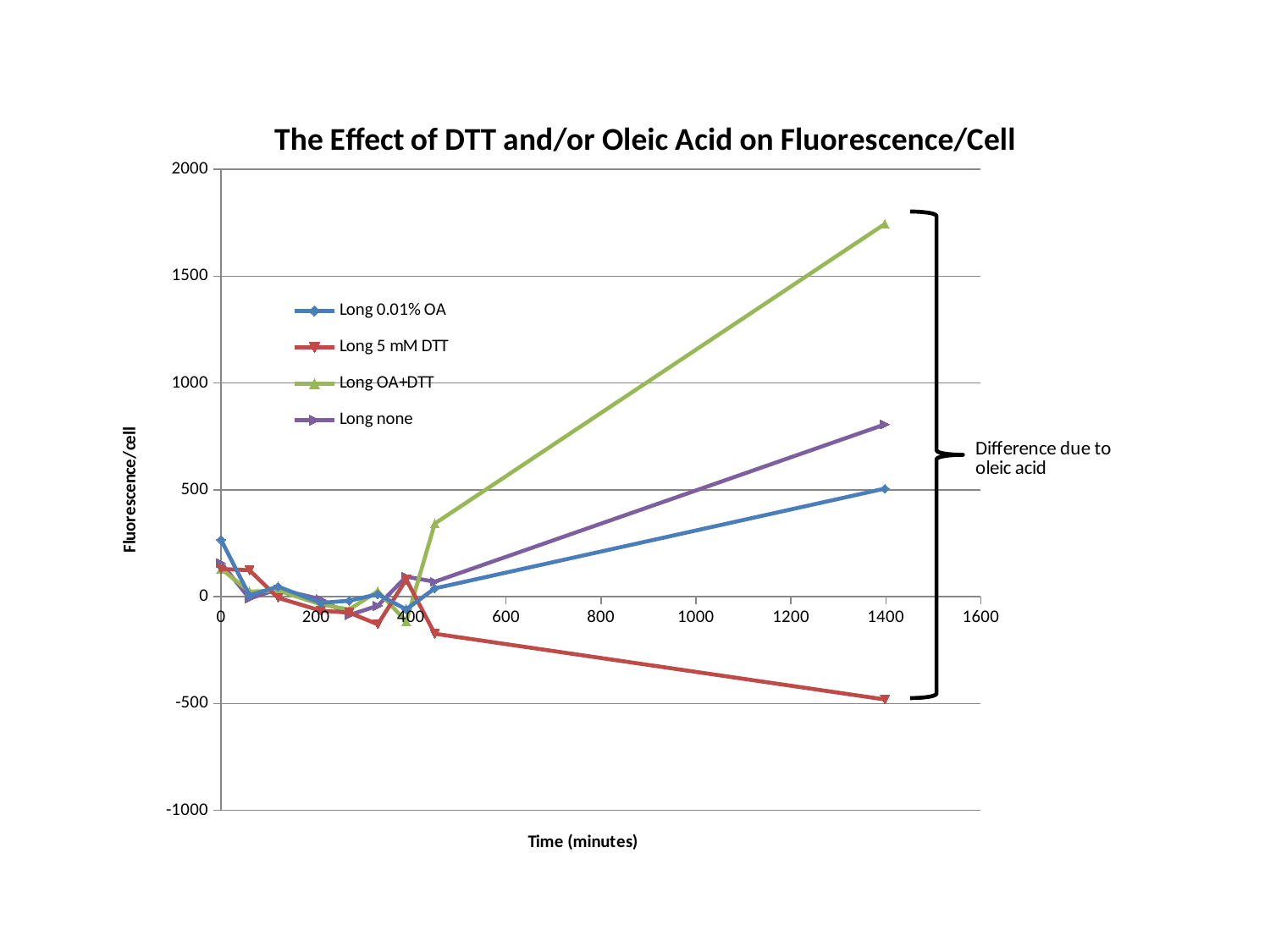
At the final time point, which is larger: the value for Long none or the value for Long 0.01% OA? Long none Does the Long 5 mM DTT series rise or fall between about 450 minutes and 1400 minutes? fall What is the title of the chart? The Effect of DTT and/or Oleic Acid on Fluorescence/Cell Which series has the lowest fluorescence/cell value at the final time point (around 1400 minutes)? Long 5 mM DTT Which series has the highest fluorescence/cell value at the final time point (around 1400 minutes)? Long OA+DTT Is the value for Long OA+DTT at the final time point greater or less than 1500? greater What label is shown on the x axis? Time (minutes) Is the value for Long none at the final time point greater or less than 500? greater What kind of chart is shown on the slide? line chart Is the value for Long 5 mM DTT at the final time point greater or less than 0? less Does the Long OA+DTT series rise or fall between about 450 minutes and 1400 minutes? rise How many series does the legend list? 4